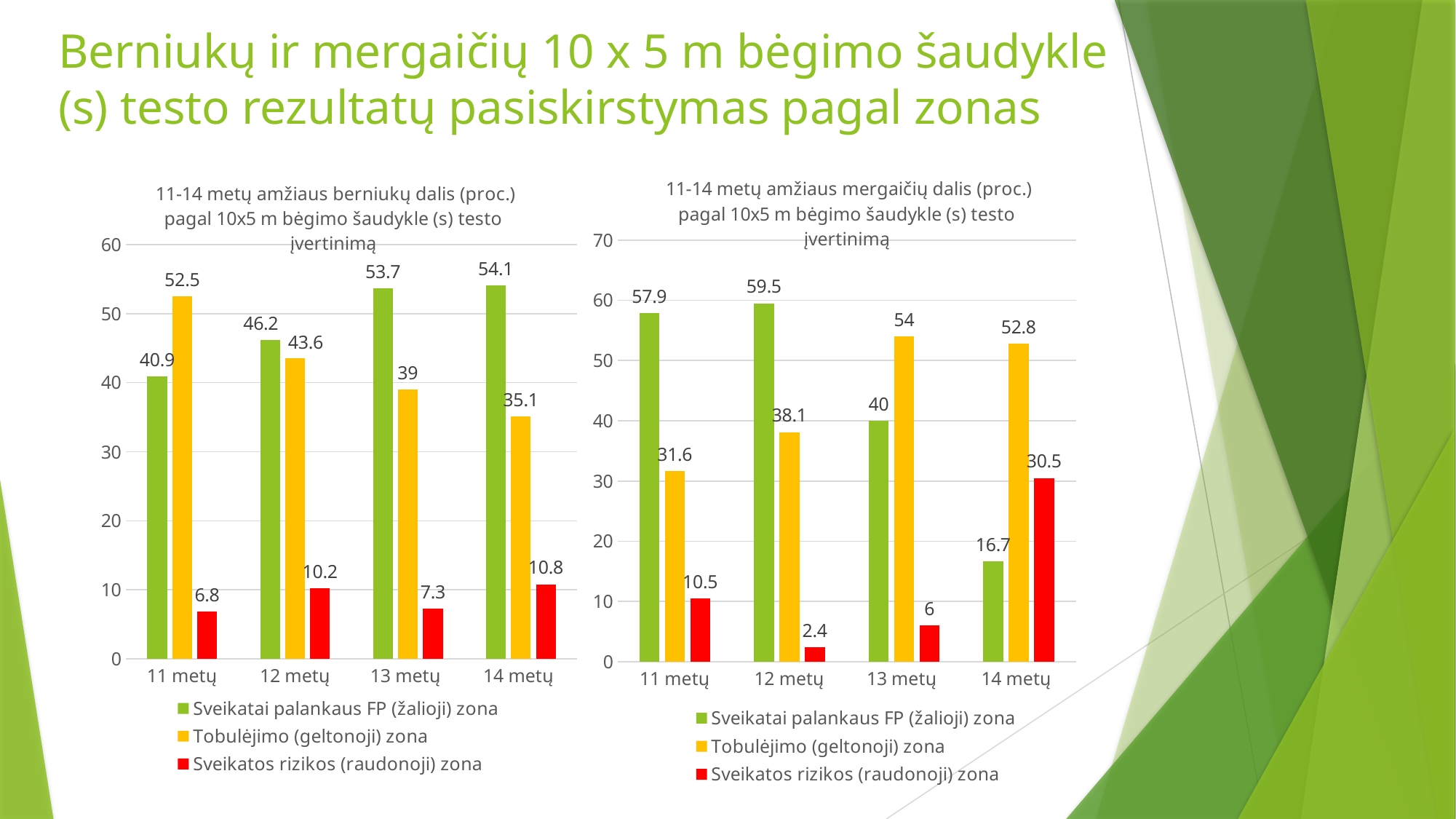
In the left chart (boys), is the value for the Sveikatai palankaus FP (žalioji) zona at 12 metų greater or less than 40? greater In the left chart (boys), do the values for the Tobulėjimo (geltonoji) zona rise or fall from 11 metų to 14 metų? Fall How many series does the legend of the left chart (boys) list? 3 What kind of chart is the right chart (girls)? Bar chart In the right chart (girls), which age group has the lowest value for the Sveikatos rizikos (raudonoji) zona? 12 metų How many age groups are shown on the x axis of the right chart (girls)? 4 In the left chart (boys), which age group has the highest value for the Sveikatai palankaus FP (žalioji) zona? 14 metų In the right chart (girls), what is the value for the Sveikatos rizikos (raudonoji) zona at 14 metų? 30.5 In the left chart (boys), what is the value for the Tobulėjimo (geltonoji) zona at 11 metų? 52.5 In the left chart (boys), what is the difference between the Tobulėjimo (geltonoji) zona values at 11 metų and 14 metų? 17.4 In the right chart (girls), which is larger at 13 metų: the Sveikatai palankaus FP (žalioji) zona or the Tobulėjimo (geltonoji) zona? Tobulėjimo (geltonoji) zona In the right chart (girls), what is the value for the Sveikatai palankaus FP (žalioji) zona at 12 metų? 59.5